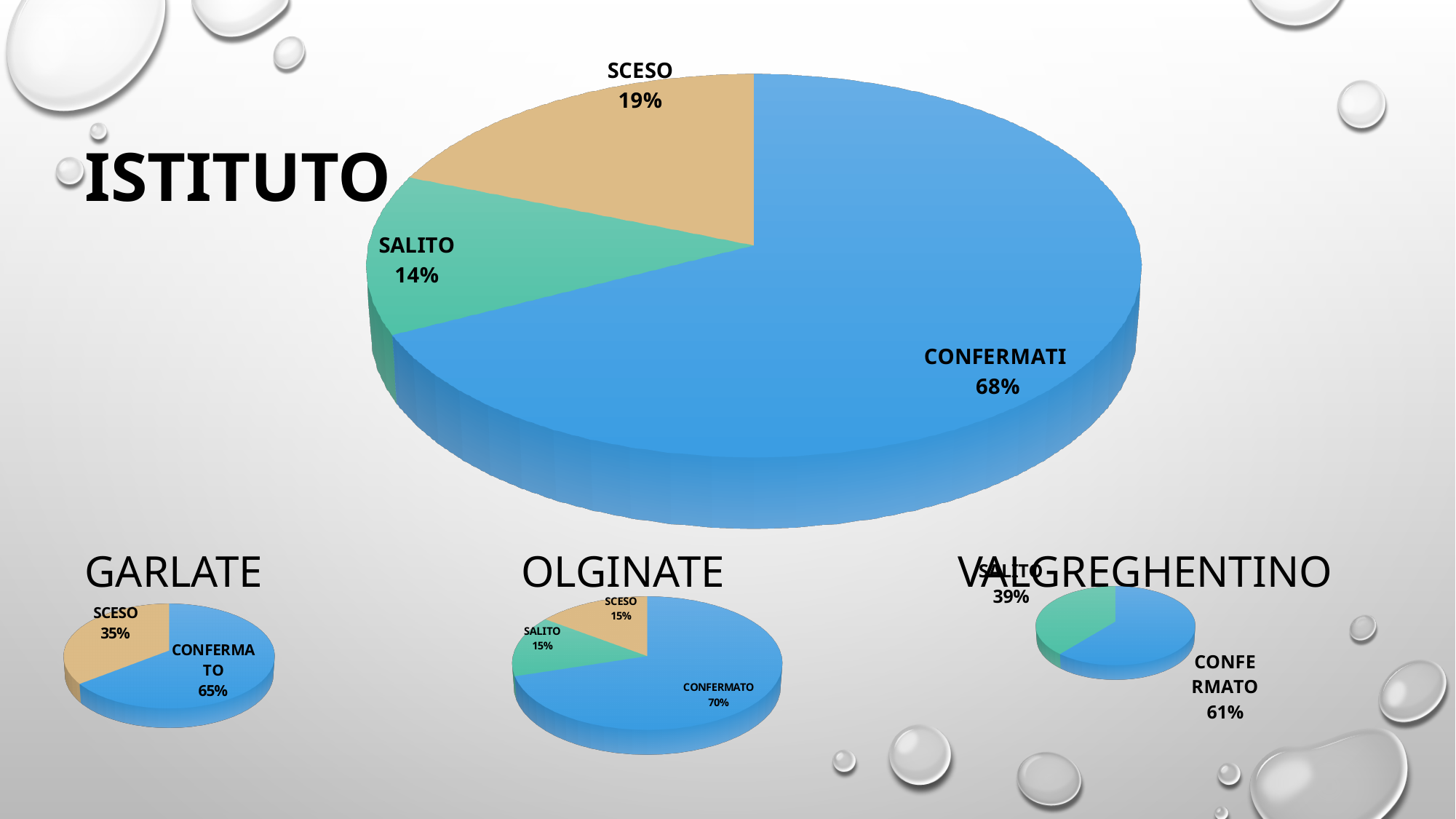
In the OLGINATE pie chart, what percentage is labelled CONFERMATO? 70% In the ISTITUTO pie chart, what percentage is labelled SALITO? 14% In the ISTITUTO pie chart, which slice is the smallest? SALITO In the OLGINATE pie chart, how many slices does the pie have? 3 In the ISTITUTO pie chart, what percentage is labelled SCESO? 19% In the ISTITUTO pie chart, which slice is the largest? CONFERMATI In the GARLATE pie chart, what percentage is labelled SCESO? 35% In the GARLATE pie chart, what percentage is labelled CONFERMATO? 65% What kind of chart is used for ISTITUTO? Pie chart In the ISTITUTO pie chart, how many percentage points larger is SCESO than SALITO? 5 In the ISTITUTO pie chart, what percentage is labelled CONFERMATI? 68% In the VALGREGHENTINO pie chart, what percentage is labelled CONFERMATO? 61%